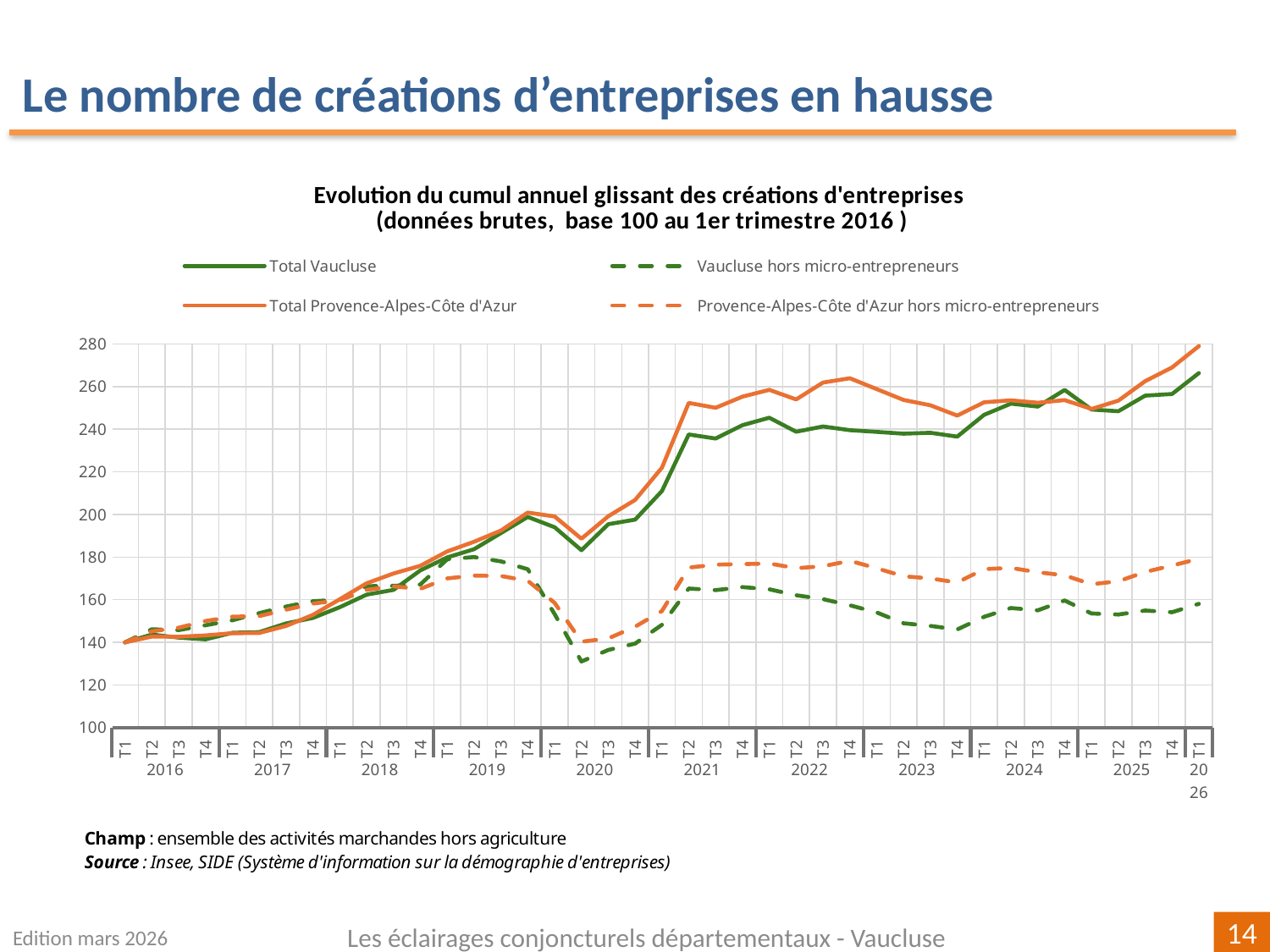
What kind of chart is shown on the slide? line chart Is the value for Vaucluse hors micro-entrepreneurs at T2 2020 greater or less than 140? less In which quarter does the Vaucluse hors micro-entrepreneurs series reach its lowest point? T2 2020 At T1 2026, which series has the highest value? Total Provence-Alpes-Côte d'Azur Does the Total Vaucluse series rise or fall overall from T1 2016 to T1 2026? rise At T4 2022, which is larger: Total Provence-Alpes-Côte d'Azur or Total Vaucluse? Total Provence-Alpes-Côte d'Azur How many years are labelled on the x axis? 11 Which series is drawn as a solid orange line? Total Provence-Alpes-Côte d'Azur Is the value for Total Vaucluse at T1 2026 greater or less than 240? greater According to the chart title, which quarter is the base 100 reference? 1er trimestre 2016 Is the value for Total Provence-Alpes-Côte d'Azur at T2 2021 greater or less than 240? greater How many series does the legend list? 4